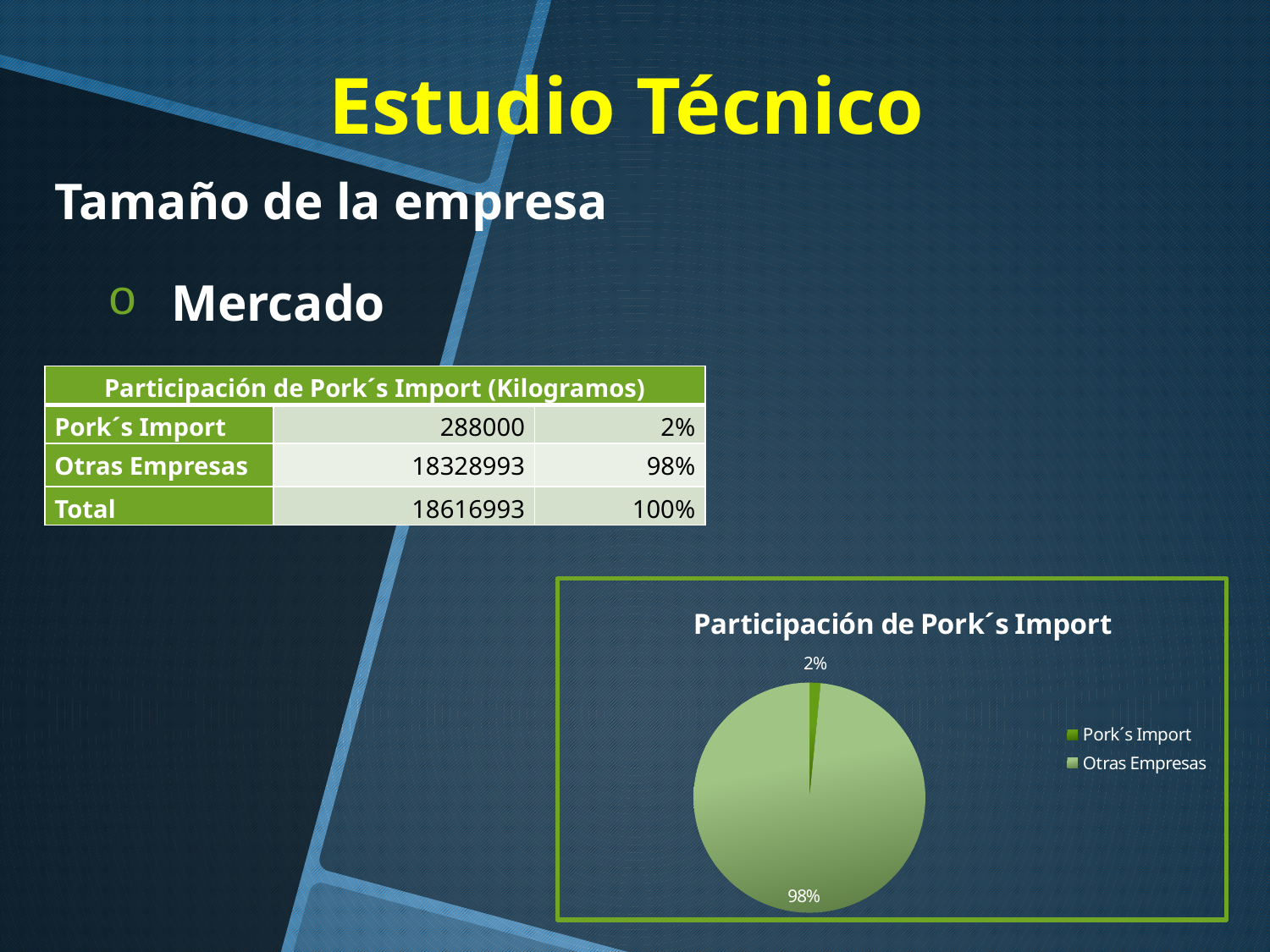
Which slice of the pie is the smallest? Pork´s Import What share of the pie does Otras Empresas represent? 98% Which slice of the pie is the largest? Otras Empresas What is the difference in percentage points between the Otras Empresas slice and the Pork´s Import slice? 96 How many entries does the chart legend list? 2 Which is larger in the pie chart, Pork´s Import or Otras Empresas? Otras Empresas How many slices does the pie chart have? 2 What is the title of the chart? Participación de Pork´s Import What share of the pie does Pork´s Import represent? 2% What kind of chart is shown on the slide? pie chart Which legend entry is listed first in the chart legend? Pork´s Import